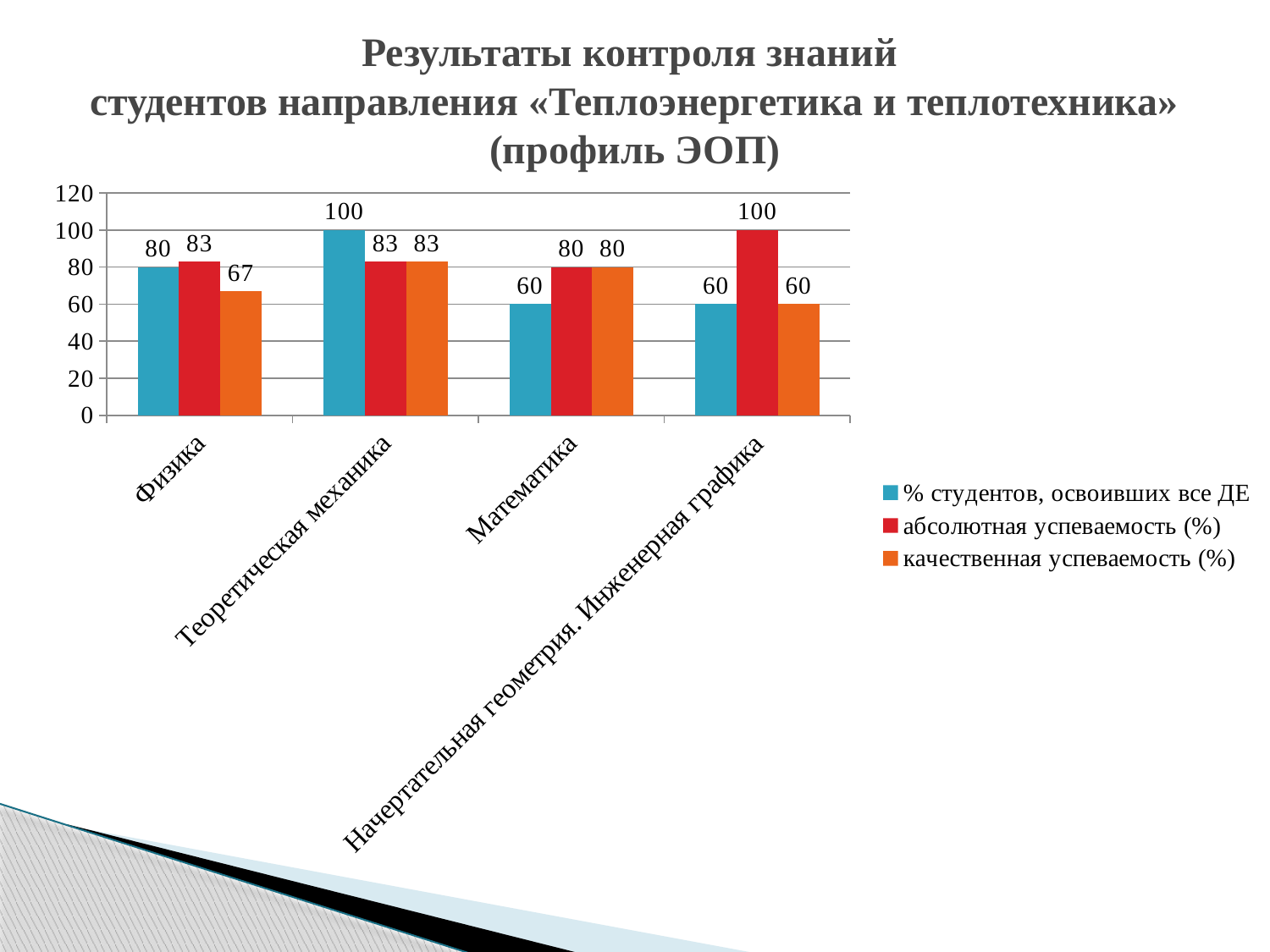
What is the difference between «абсолютная успеваемость (%)» and «качественная успеваемость (%)» for Физика? 16 Which subject has the lowest value for «качественная успеваемость (%)»? Начертательная геометрия. Инженерная графика What is the value of «% студентов, освоивших все ДЕ» for Физика? 80 How many series does the legend list? 3 What is the value of «качественная успеваемость (%)» for Физика? 67 How many categories (subjects) are shown on the x axis? 4 What type of chart is shown on the slide? bar chart Which subject has the highest value for «% студентов, освоивших все ДЕ»? Теоретическая механика Which series is shown in red in the legend? абсолютная успеваемость (%) Which is larger for Математика: «% студентов, освоивших все ДЕ» or «абсолютная успеваемость (%)»? абсолютная успеваемость (%) What is the value of «% студентов, освоивших все ДЕ» for Математика? 60 What is the value of «абсолютная успеваемость (%)» for Начертательная геометрия. Инженерная графика? 100